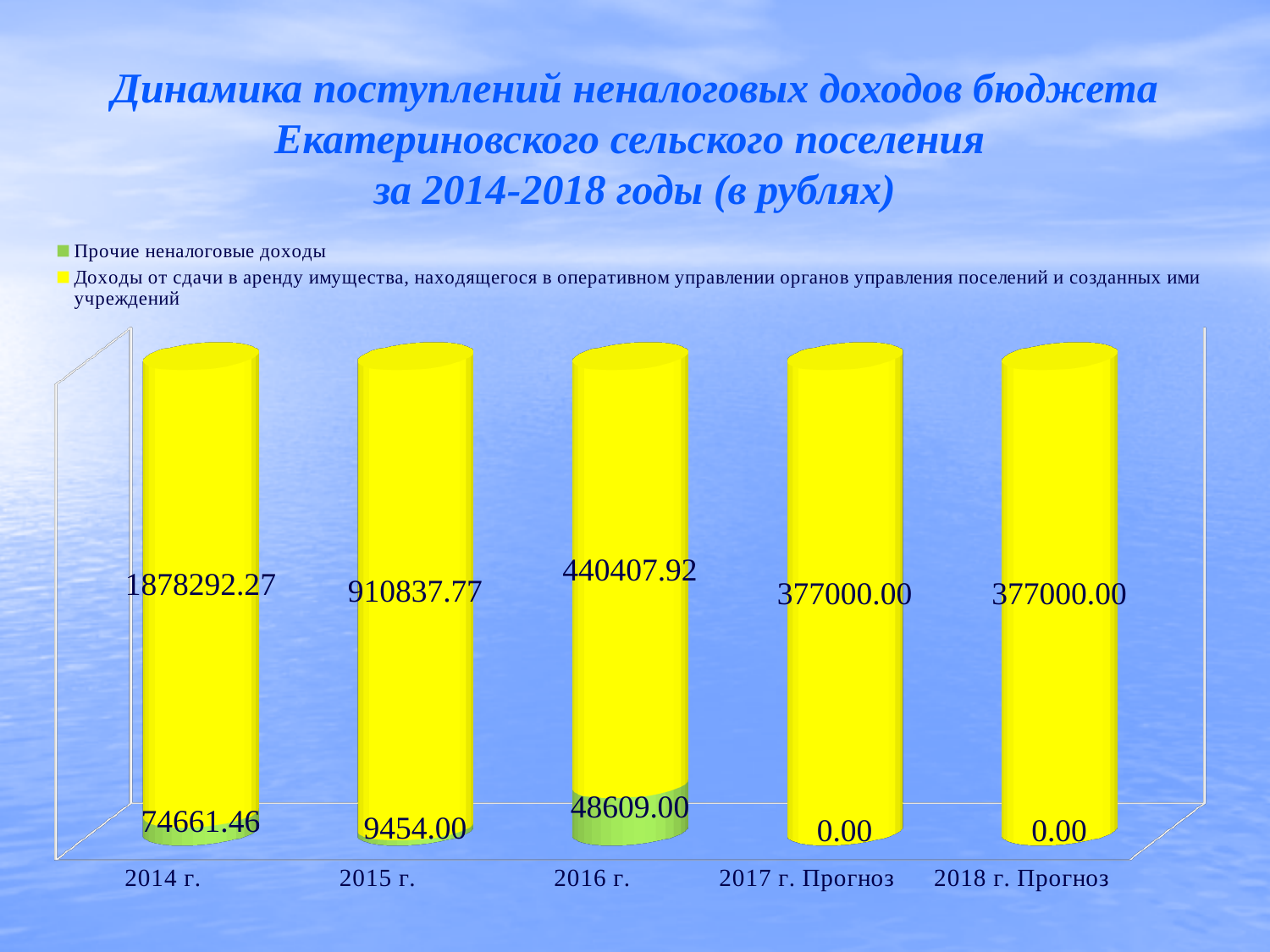
Which year has the lowest value for 'Прочие неналоговые доходы' among 2014 г., 2015 г. and 2016 г.? 2015 г. Which is larger: 'Прочие неналоговые доходы' for 2014 г. or for 2016 г.? 2014 г. What is the total of the two series for 2016 г.? 489016.92 What is the value of 'Доходы от сдачи в аренду имущества' for 2014 г.? 1878292.27 What is the value of 'Прочие неналоговые доходы' for 2015 г.? 9454.00 What is the difference between the 'Доходы от сдачи в аренду имущества' values for 2014 г. and 2015 г.? 967454.50 How many years (categories) are shown on the x axis? 5 What is the value of 'Прочие неналоговые доходы' for 2016 г.? 48609.00 Which year has the highest value for 'Доходы от сдачи в аренду имущества'? 2014 г. What is the value of 'Доходы от сдачи в аренду имущества' for 2018 г. Прогноз? 377000.00 What kind of chart is shown on the slide? Stacked bar chart How many series does the legend list? 2